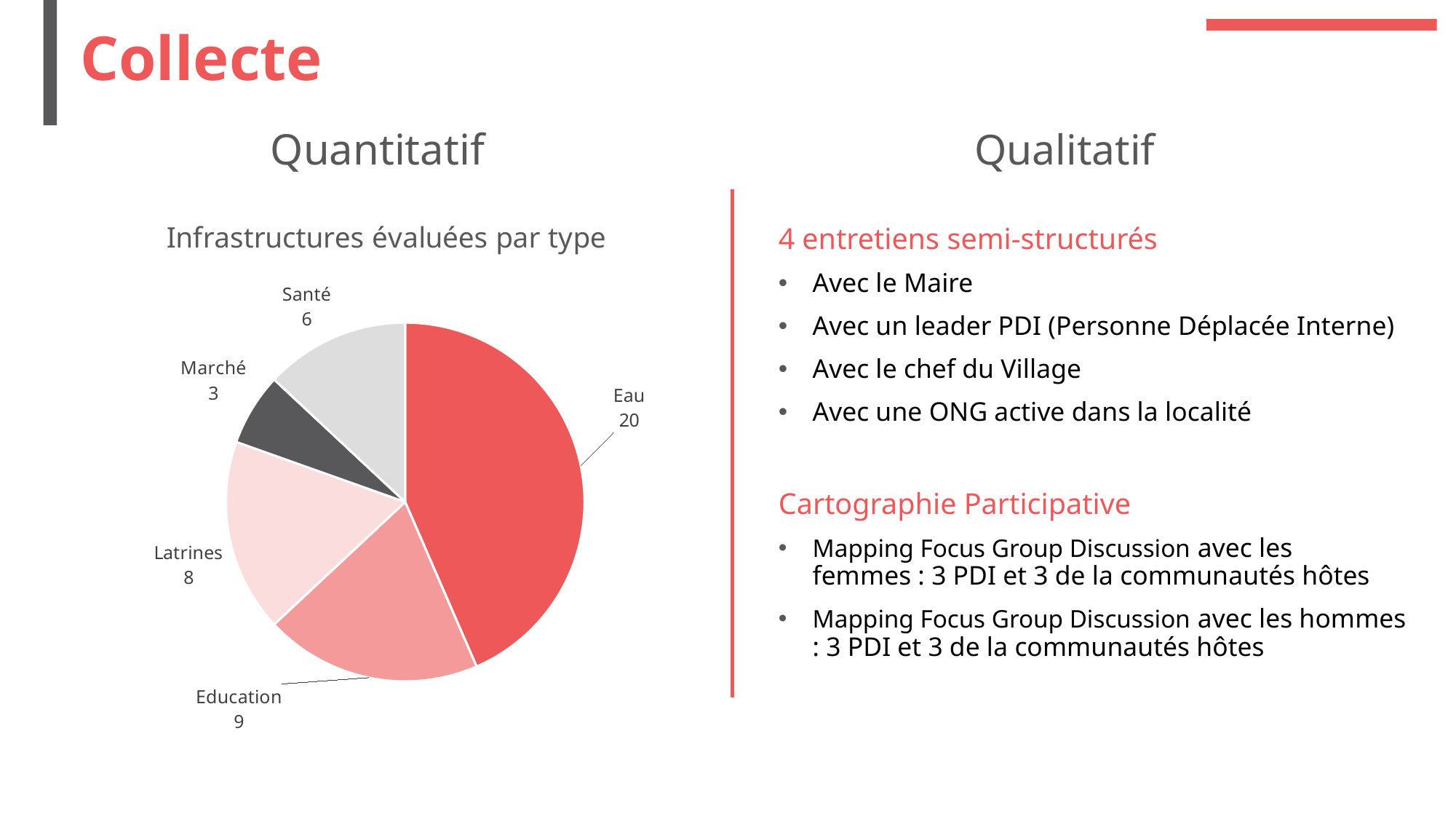
What is the value for Santé in the pie chart? 6 How many categories are shown in the pie chart? 5 What type of chart is shown under 'Infrastructures évaluées par type'? pie chart What is the value for Eau in the pie chart? 20 What is the value for Marché in the pie chart? 3 Which category has the smallest slice in the pie chart? Marché What is the difference between the values for Eau and Education in the pie chart? 11 What is the value for Education in the pie chart? 9 What is the value for Latrines in the pie chart? 8 Which is larger in the pie chart, Santé or Marché? Santé Which category has the largest slice in the pie chart? Eau What is the title of the pie chart? Infrastructures évaluées par type